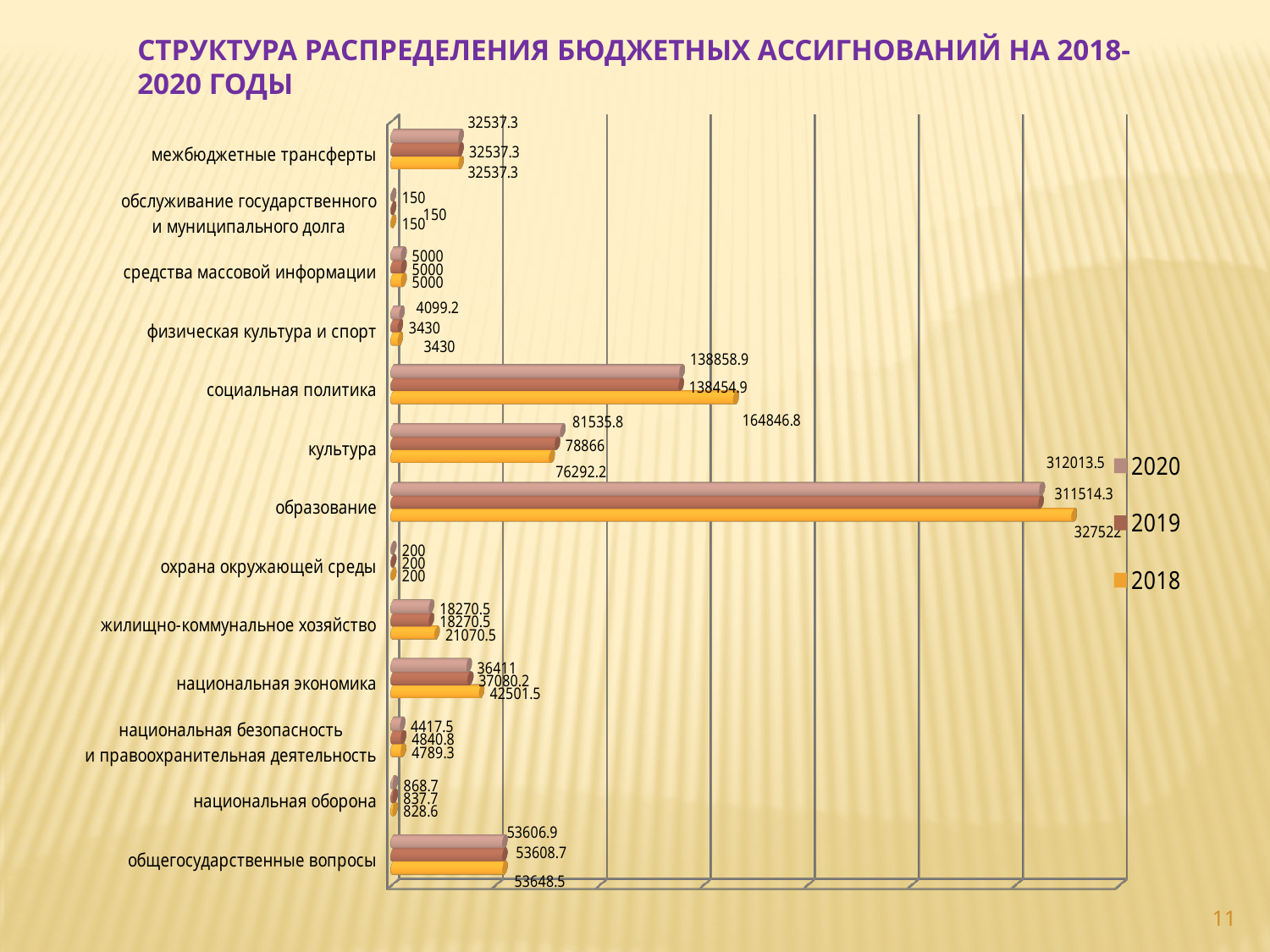
What kind of chart is shown on the slide? bar chart How many categories are shown on the chart? 13 Which series is shown in orange in the legend? 2018 Which category has the highest value in 2020? образование Which is larger for жилищно-коммунальное хозяйство: the 2018 value or the 2020 value? 2018 What is the value for социальная политика in 2020? 138858.9 What is the value for образование in 2018? 327522 What is the value for национальная экономика in 2018? 42501.5 Which category has the lowest value in 2018? обслуживание государственного и муниципального долга What is the difference between the 2018 and 2020 values for социальная политика? 25987.9 How many series does the legend list? 3 What is the value for культура in 2019? 78866